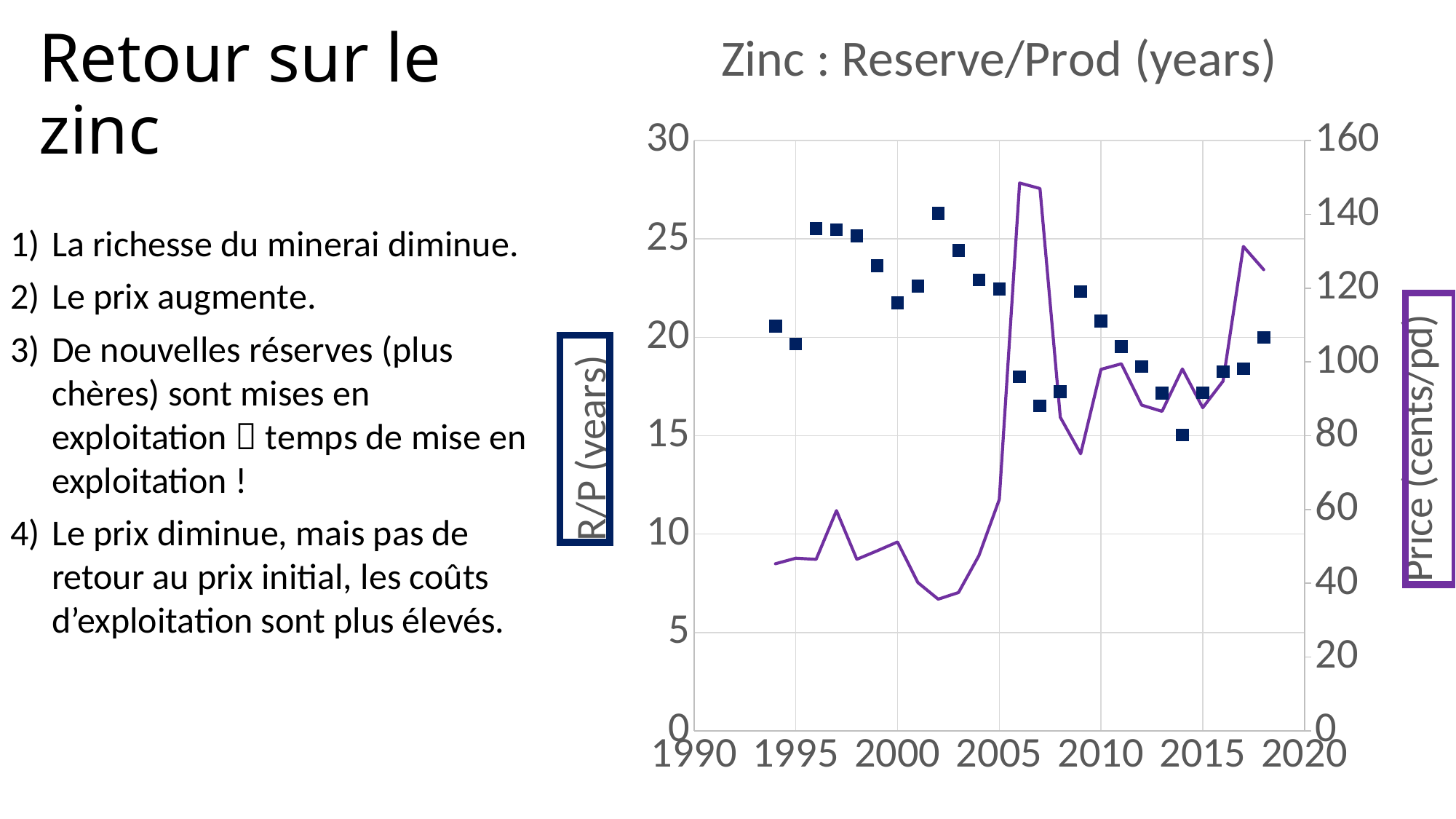
Does the price rise or fall between 2002 and 2006? rise In which year does the price line reach its highest value? 2006 Is the R/P value for 2002 greater or less than 25? greater Is the price value for 2017 greater or less than 120? greater Is the price value for 2006 greater or less than 140? greater Does the R/P value rise or fall between 2002 and 2007? fall What is the label of the right-hand vertical axis? Price (cents/pd) What is the title of the chart? Zinc : Reserve/Prod (years) In which year is the R/P value lowest? 2014